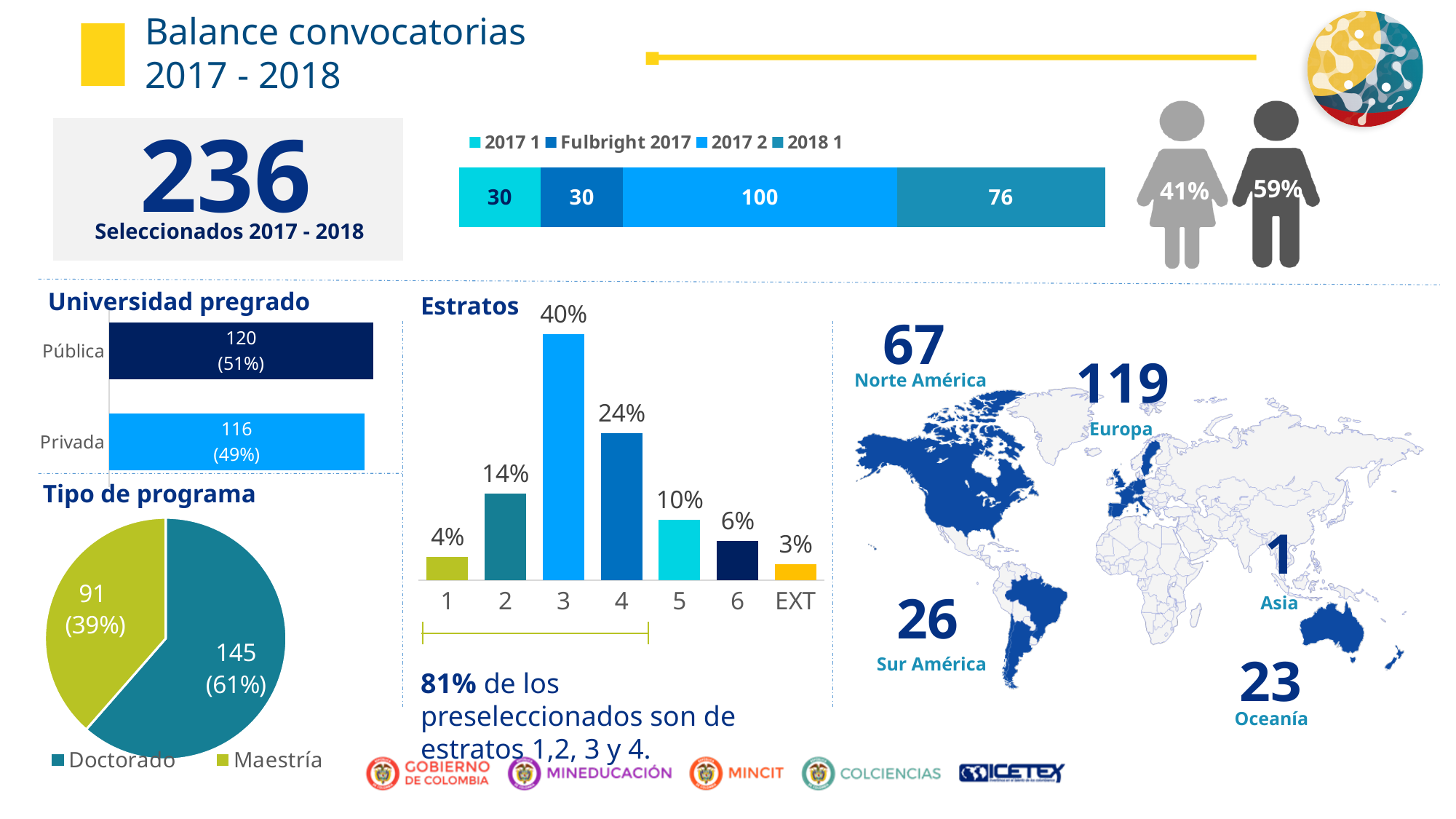
In the Estratos chart, how many categories are shown on the x axis? 7 In the Estratos chart, which category has the lowest value? EXT In the stacked bar chart at the top of the slide, which series has the largest value? 2017 2 In the Universidad pregrado chart, what is the value for Pública? 120 In the Universidad pregrado chart, what is the difference between the Pública and Privada values? 4 What kind of chart is the Tipo de programa chart? pie chart In the Estratos chart, which is larger, the value for estrato 2 or estrato 4? estrato 4 In the Tipo de programa pie chart, what share does Doctorado have? 61% In the stacked bar chart at the top of the slide, what is the total of the four segments? 236 In the stacked bar chart at the top of the slide, what is the value for the 2017 2 series? 100 In the stacked bar chart at the top of the slide, how many series does the legend list? 4 In the Estratos chart, what is the value for estrato 3? 40%